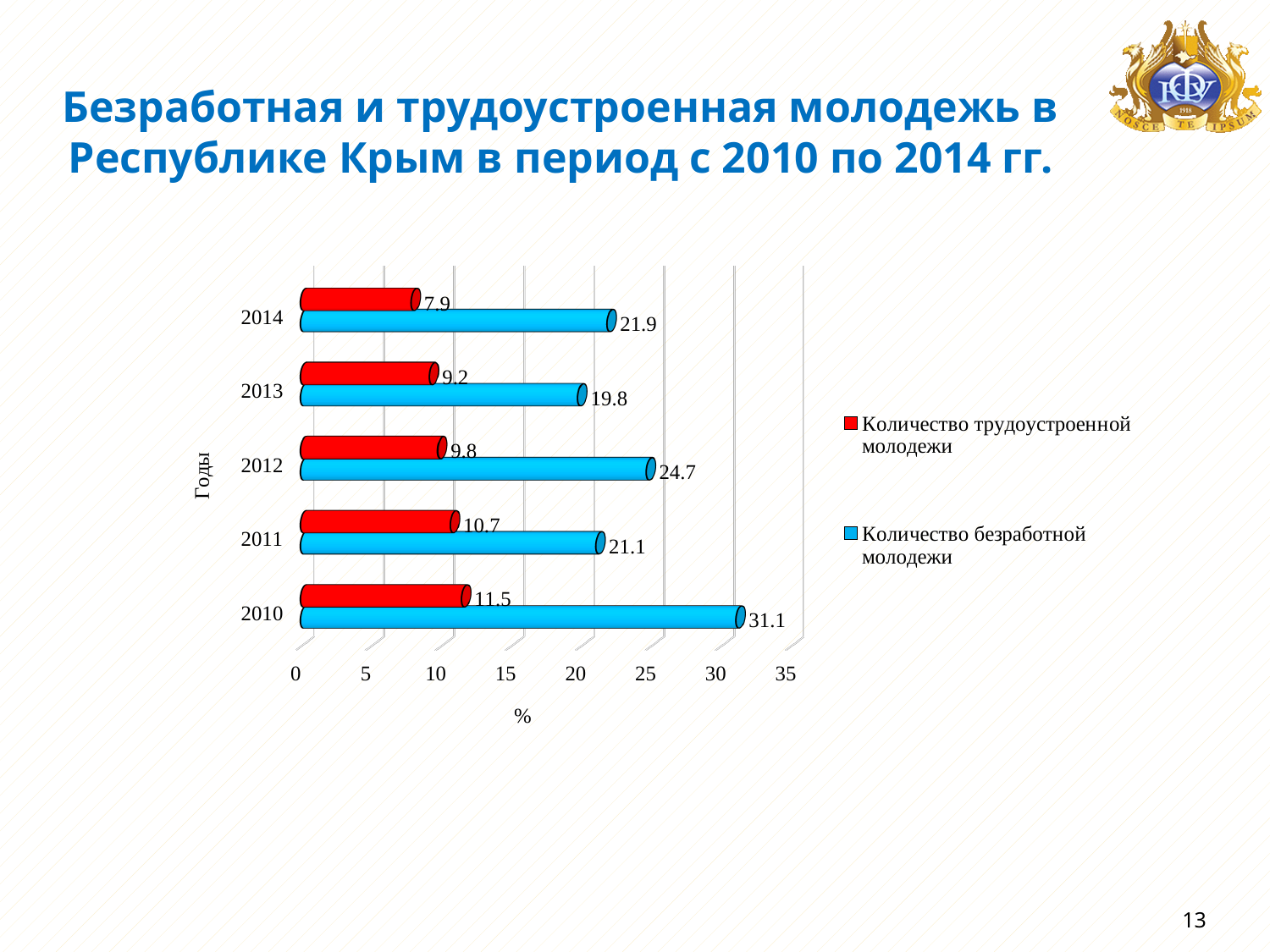
What colour represents Количество безработной молодежи in the chart? blue What kind of chart is shown on the slide? bar chart In which year is Количество трудоустроенной молодежи lowest? 2014 What is the value for Количество трудоустроенной молодежи in 2014? 7.9 Which is larger: Количество безработной молодежи in 2011 or in 2014? 2014 In which year is Количество безработной молодежи highest? 2010 What is the value for Количество безработной молодежи in 2010? 31.1 What is the value for Количество безработной молодежи in 2013? 19.8 How many series does the legend list? 2 What is the difference between Количество безработной молодежи and Количество трудоустроенной молодежи in 2012? 14.9 How many years are shown on the chart? 5 Does Количество трудоустроенной молодежи rise or fall from 2010 to 2014? fall